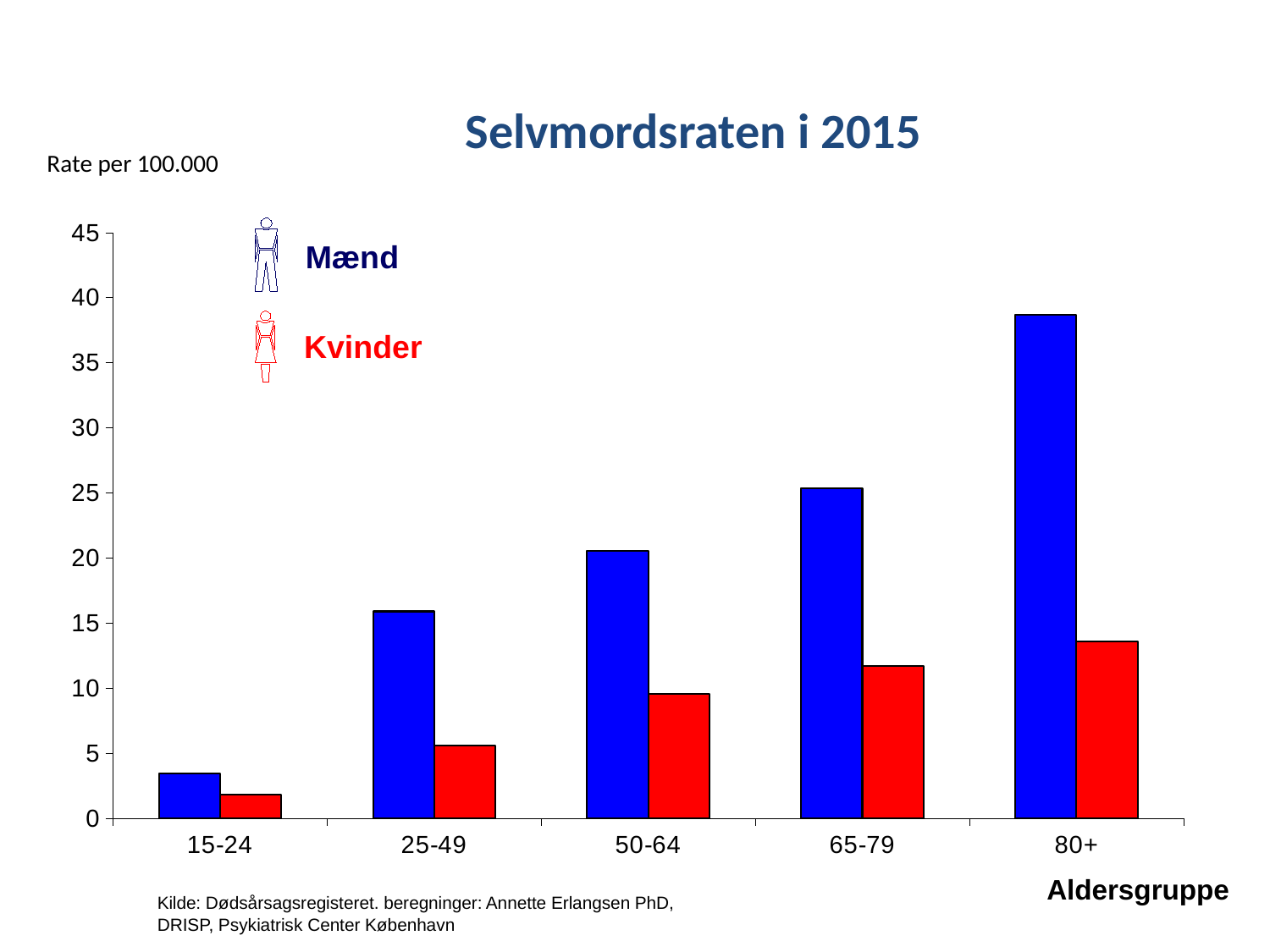
How many series does the legend list? 2 Do the Kvinder values rise or fall as the age groups increase along the x axis? rise Is the Kvinder value for 15-24 greater or less than 5? less How many age groups are shown on the x axis? 5 Is the Mænd value for 65-79 greater or less than 20? greater Is the Kvinder value for 80+ greater or less than 10? greater Which is larger for the 50-64 age group, the Mænd value or the Kvinder value? Mænd Which age group has the lowest rate for Kvinder? 15-24 What is the title of the chart? Selvmordsraten i 2015 What kind of chart is shown on the slide? bar chart Which age group has the highest rate for Mænd? 80+